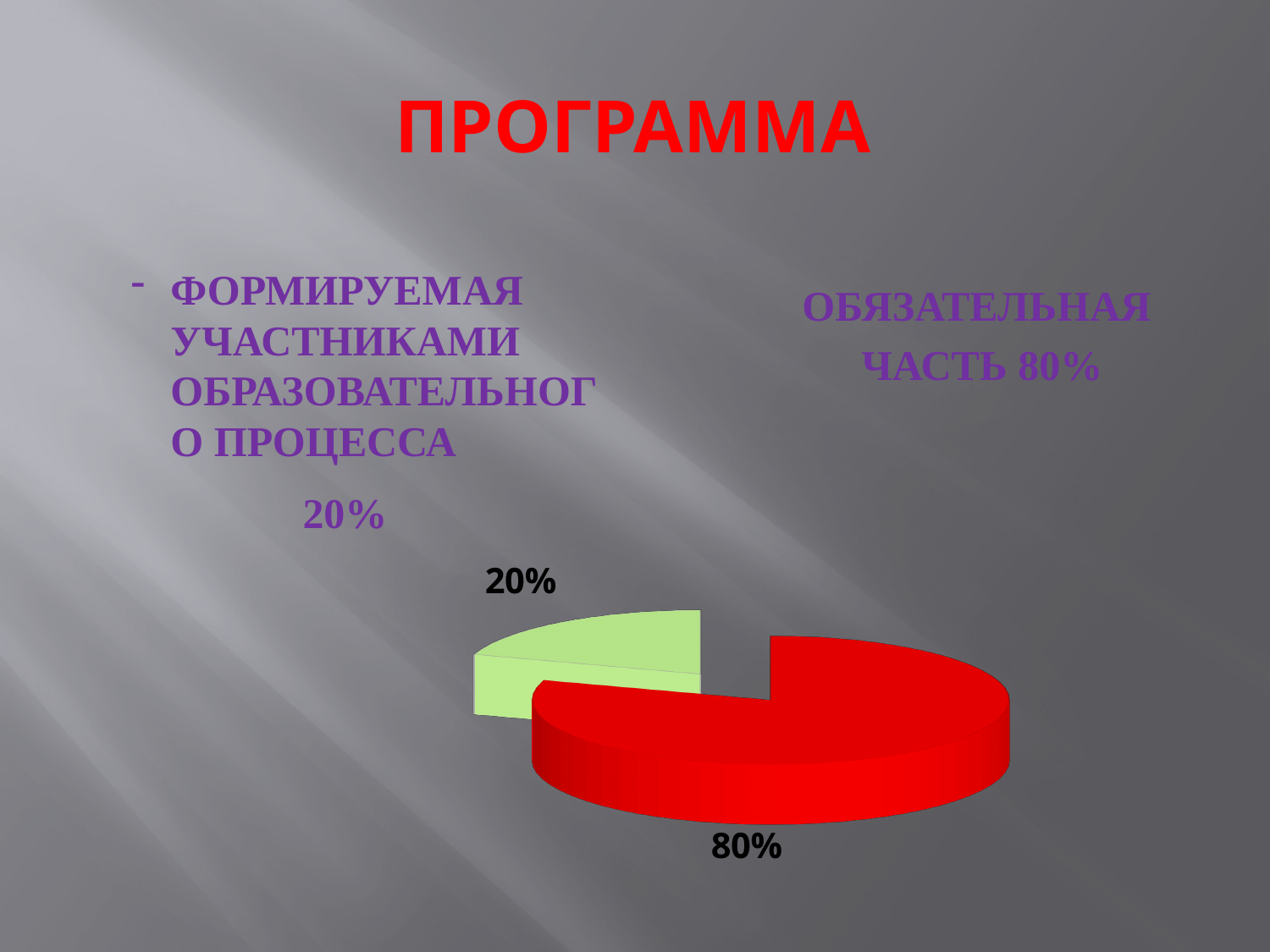
Which slice of the pie chart is the smallest? 20% Which slice of the pie chart is the largest? 80% What percentage is shown for the green slice of the pie chart? 20% What share of the pie does the ОБЯЗАТЕЛЬНАЯ ЧАСТЬ (mandatory part) take? 80% How many slices does the pie chart have? 2 What is the total of the two slices shown in the pie chart? 100% What colour is the slice labelled 20%? green What is the difference in percentage points between the two slices of the pie chart? 60 What percentage is shown for the red slice of the pie chart? 80% Which slice is larger, the red one or the green one? the red one What kind of chart is shown on the slide? pie chart What share of the pie does the part ФОРМИРУЕМАЯ УЧАСТНИКАМИ ОБРАЗОВАТЕЛЬНОГО ПРОЦЕССА take? 20%